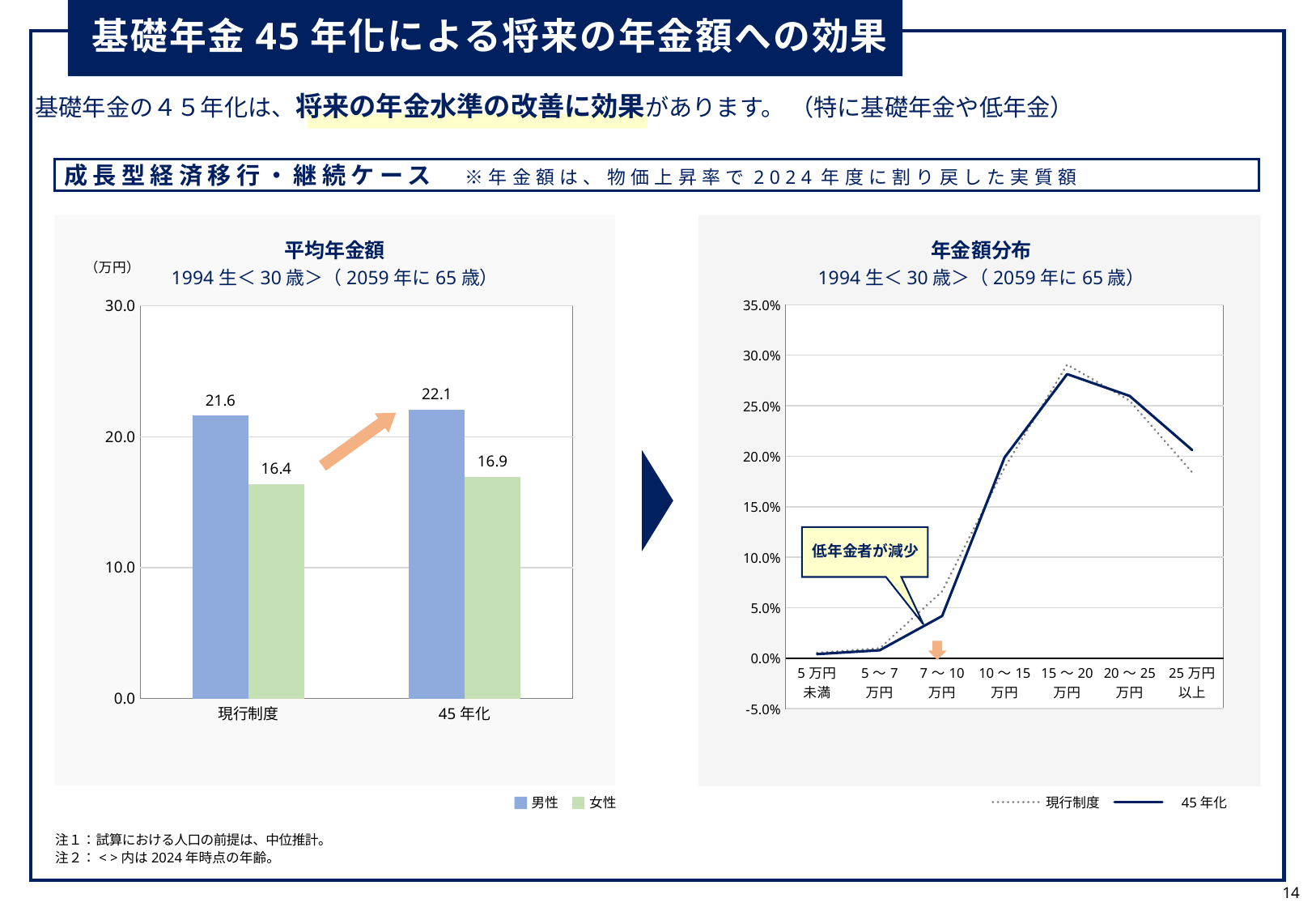
What kind of chart is the 平均年金額 chart? bar chart In the 平均年金額 chart, what is the value for 男性 under 45年化? 22.1 In the 平均年金額 chart, which bar is the highest? 男性, 45年化 How many series does the legend of the 平均年金額 chart list? 2 In the 平均年金額 chart, what is the value for 女性 under 45年化? 16.9 In the 年金額分布 chart, how many income categories are shown on the x axis? 7 In the 平均年金額 chart, which is larger: 女性 under 現行制度 or 女性 under 45年化? 女性 under 45年化 In the 平均年金額 chart, what is the difference between 男性 and 女性 under 現行制度? 5.2 In the 平均年金額 chart, what is the difference between the 男性 values for 45年化 and 現行制度? 0.5 In the 平均年金額 chart, what is the value for 男性 under 現行制度? 21.6 What kind of chart is the 年金額分布 chart? line chart In the 年金額分布 chart, is the 45年化 value for 15～20万円 greater or less than 25.0%? greater